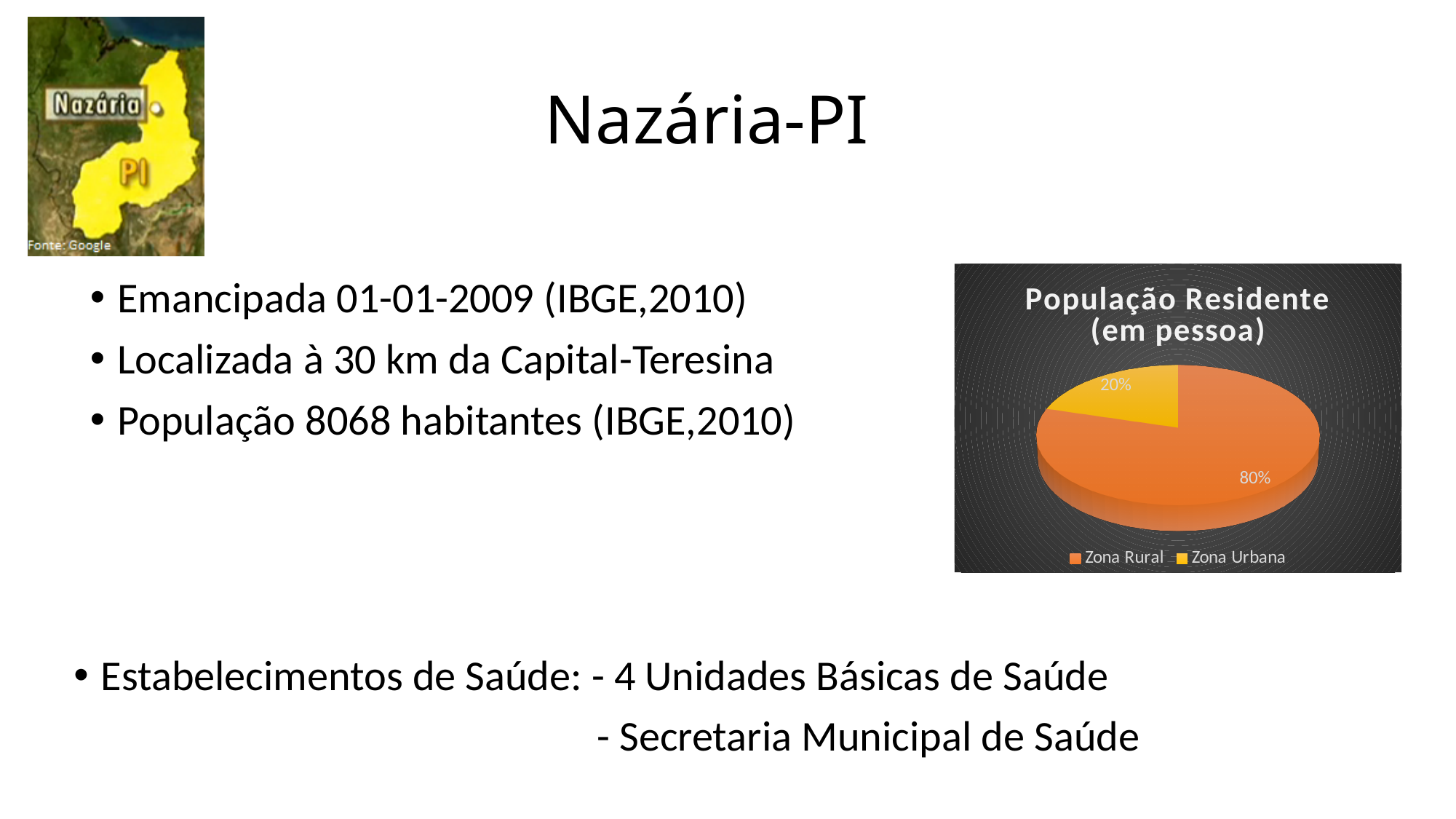
What colour is the Zona Urbana slice? Yellow What kind of chart is shown on the slide? Pie chart What share of the pie does Zona Urbana represent? 20% Which is larger, the Zona Rural slice or the Zona Urbana slice? Zona Rural Which category has the smallest slice of the pie? Zona Urbana What is the title of the chart? População Residente (em pessoa) What share of the pie does Zona Rural represent? 80% What is the difference in percentage points between Zona Rural and Zona Urbana? 60 How many categories does the pie chart show? 2 Which category has the largest slice of the pie? Zona Rural